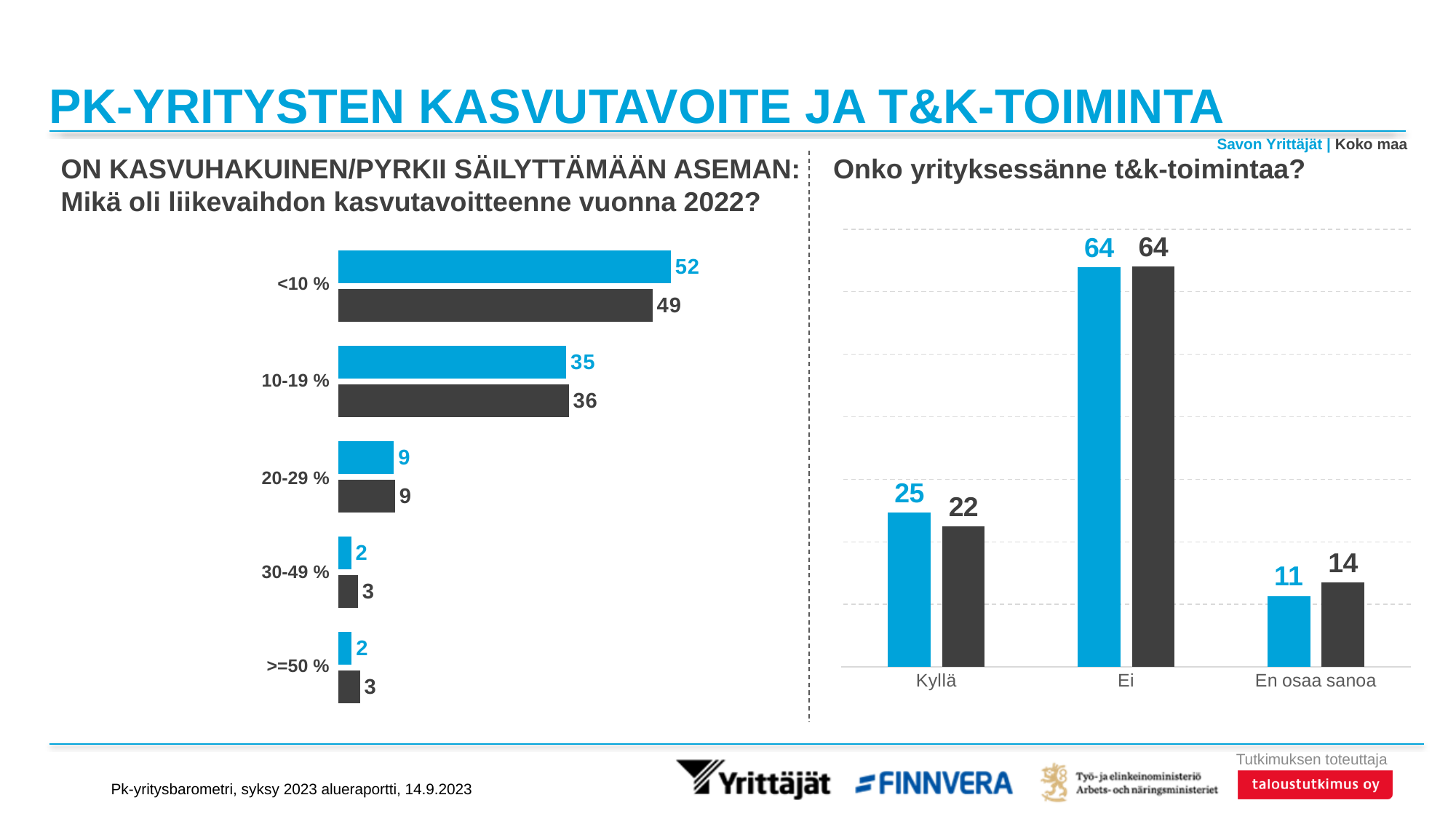
In the left chart (liikevaihdon kasvutavoite 2022), how many growth-target categories are shown? 5 In the left chart (liikevaihdon kasvutavoite 2022), which category has the highest value for Koko maa? <10 % In the right chart (Onko yrityksessänne t&k-toimintaa?), what is the value for Savon Yrittäjät for Kyllä? 25 What type of chart is the right chart (Onko yrityksessänne t&k-toimintaa?)? Bar chart How many series does the legend at the top right of the slide list? 2 In the right chart (Onko yrityksessänne t&k-toimintaa?), what is the difference between the Savon Yrittäjät and Koko maa values for Kyllä? 3 In the right chart (Onko yrityksessänne t&k-toimintaa?), what is the value for Koko maa for En osaa sanoa? 14 In the right chart (Onko yrityksessänne t&k-toimintaa?), which category has the lowest value for Savon Yrittäjät? En osaa sanoa In the left chart (liikevaihdon kasvutavoite 2022), which is larger in the 30-49 % category: Savon Yrittäjät or Koko maa? Koko maa In the left chart (liikevaihdon kasvutavoite 2022), what is the value for Savon Yrittäjät in the <10 % category? 52 In the left chart (liikevaihdon kasvutavoite 2022), what is the difference between the Savon Yrittäjät and Koko maa values in the <10 % category? 3 In the left chart (liikevaihdon kasvutavoite 2022), what is the value for Koko maa in the 10-19 % category? 36